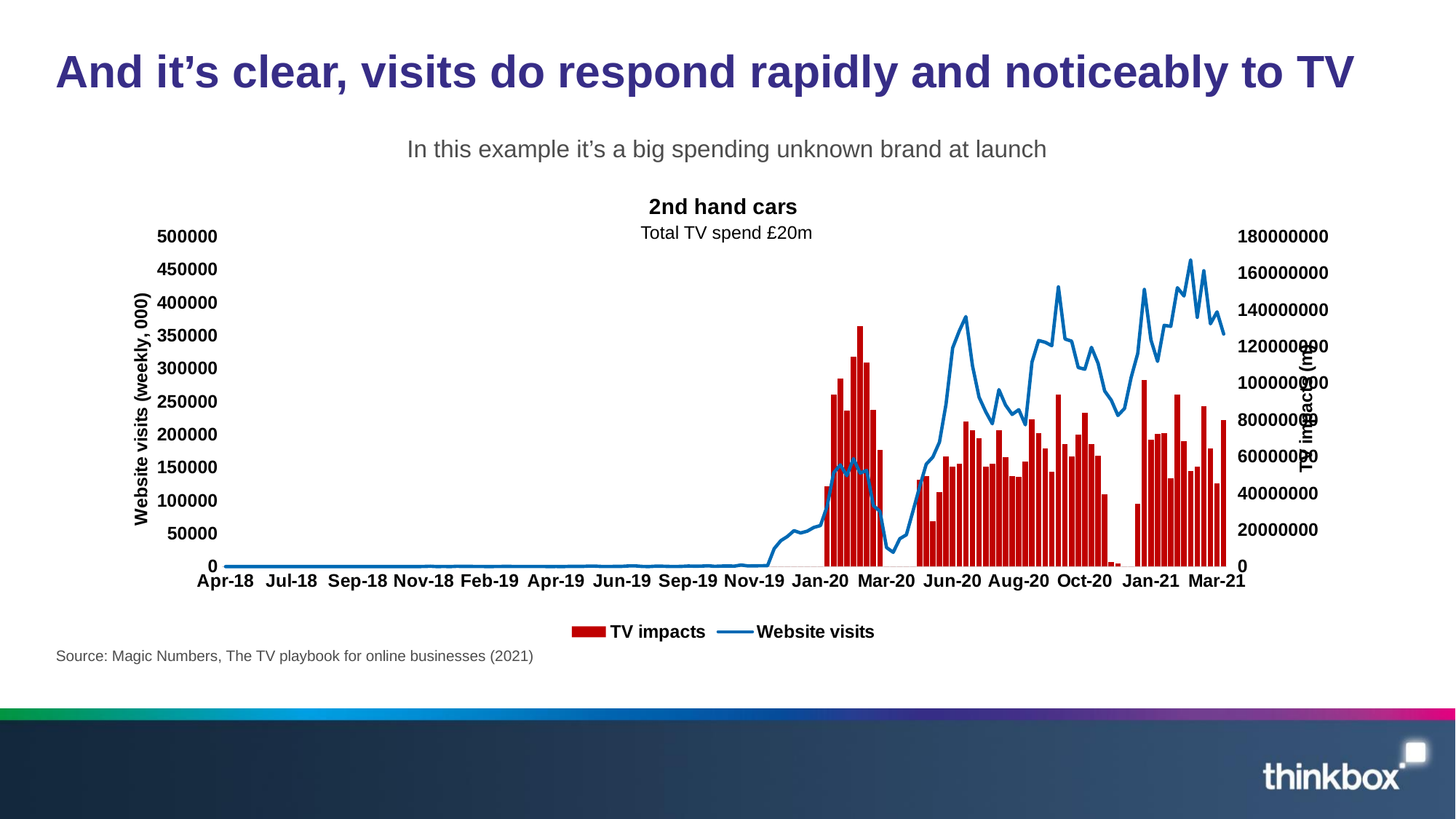
How many date labels are shown on the x axis? 16 Which series is drawn as red bars according to the legend? TV impacts Is the value for TV impacts in Jul-18 greater or less than 20000000? less Which is larger, Website visits in Apr-18 or Website visits in Mar-21? Mar-21 Is the peak value of Website visits greater or less than 400000? greater Is the value for Website visits in Apr-18 greater or less than 50000? less What is the title of the chart? 2nd hand cars What kind of chart is shown on the slide? A combined bar and line chart How many series does the legend list? 2 Overall, do Website visits rise or fall from Apr-18 to Mar-21? rise